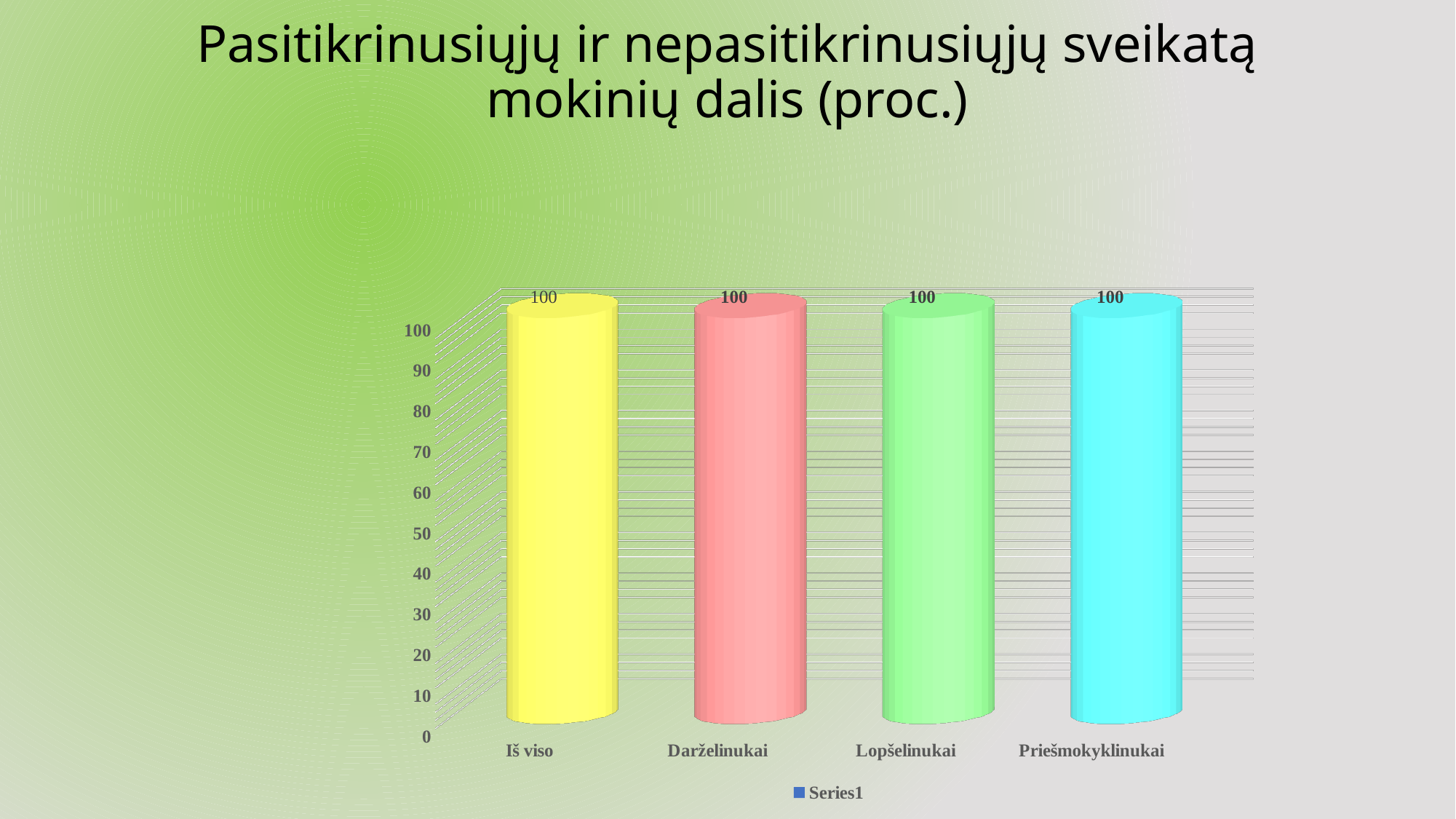
What is the difference between the values for Darželinukai and Lopšelinukai? 0 How many categories are shown on the x axis? 4 Is the value for Priešmokyklinukai greater or less than 50? greater What is the value for Iš viso? 100 How many series does the legend list? 1 What is the value for Lopšelinukai? 100 What kind of chart is shown on the slide? bar chart What is the value for Priešmokyklinukai? 100 What is the value for Darželinukai? 100 What colour is the bar for Darželinukai? pink What is the name of the series listed in the legend? Series1 Do the values rise, fall or stay the same across the categories from left to right? stay the same